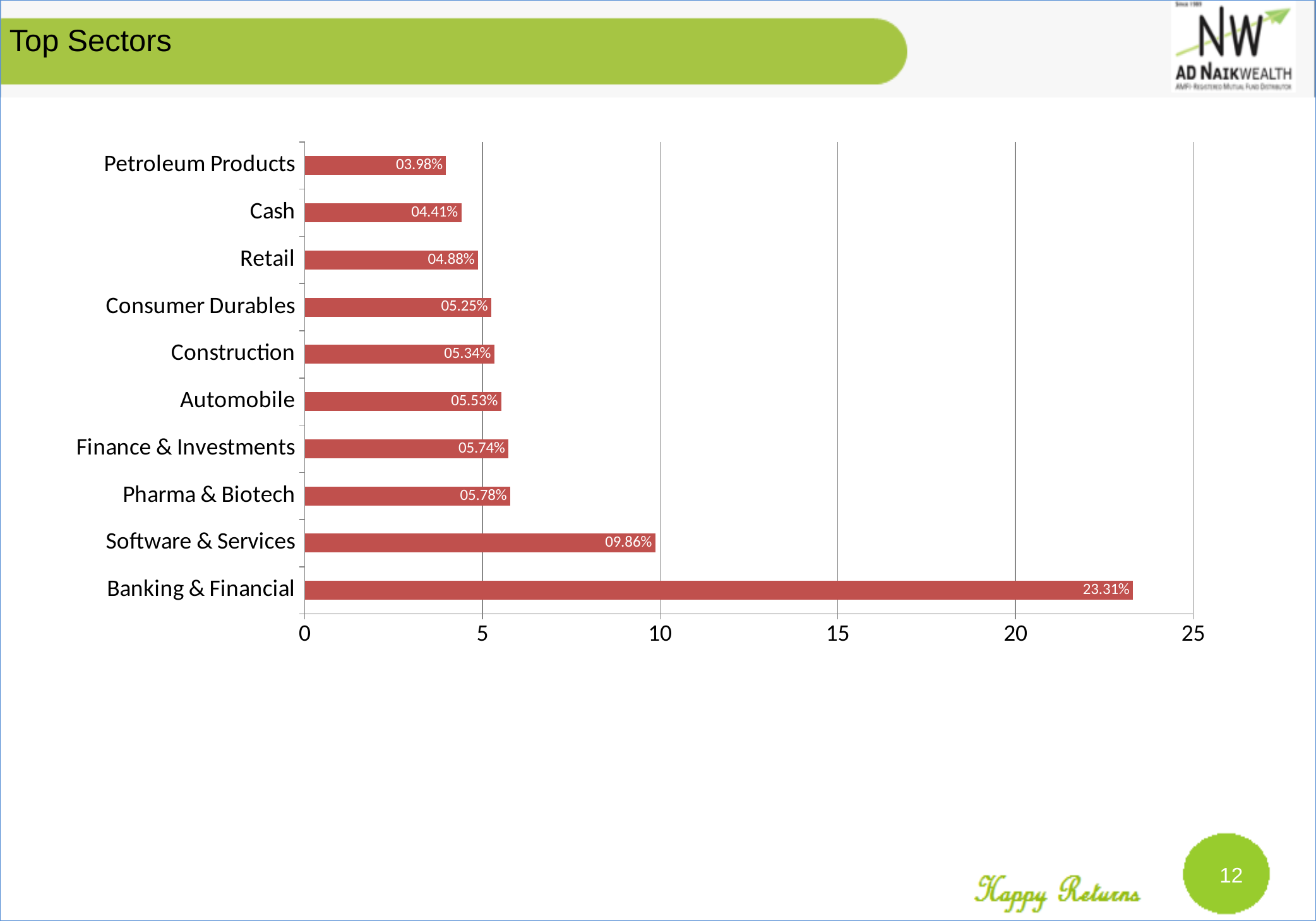
What is the value for Consumer Durables? 05.25% Is the value for Banking & Financial greater or less than 20? greater What is the difference between the values for Retail and Cash? 0.47% What is the difference between the values for Banking & Financial and Software & Services? 13.45% What is the value for Software & Services? 09.86% Which sector has the highest value? Banking & Financial How many sectors are shown in the chart? 10 What kind of chart is shown on the slide? Bar chart What is the value for Petroleum Products? 03.98% Which is larger, the value for Software & Services or the value for Pharma & Biotech? Software & Services Which sector has the lowest value? Petroleum Products What is the value for Banking & Financial? 23.31%